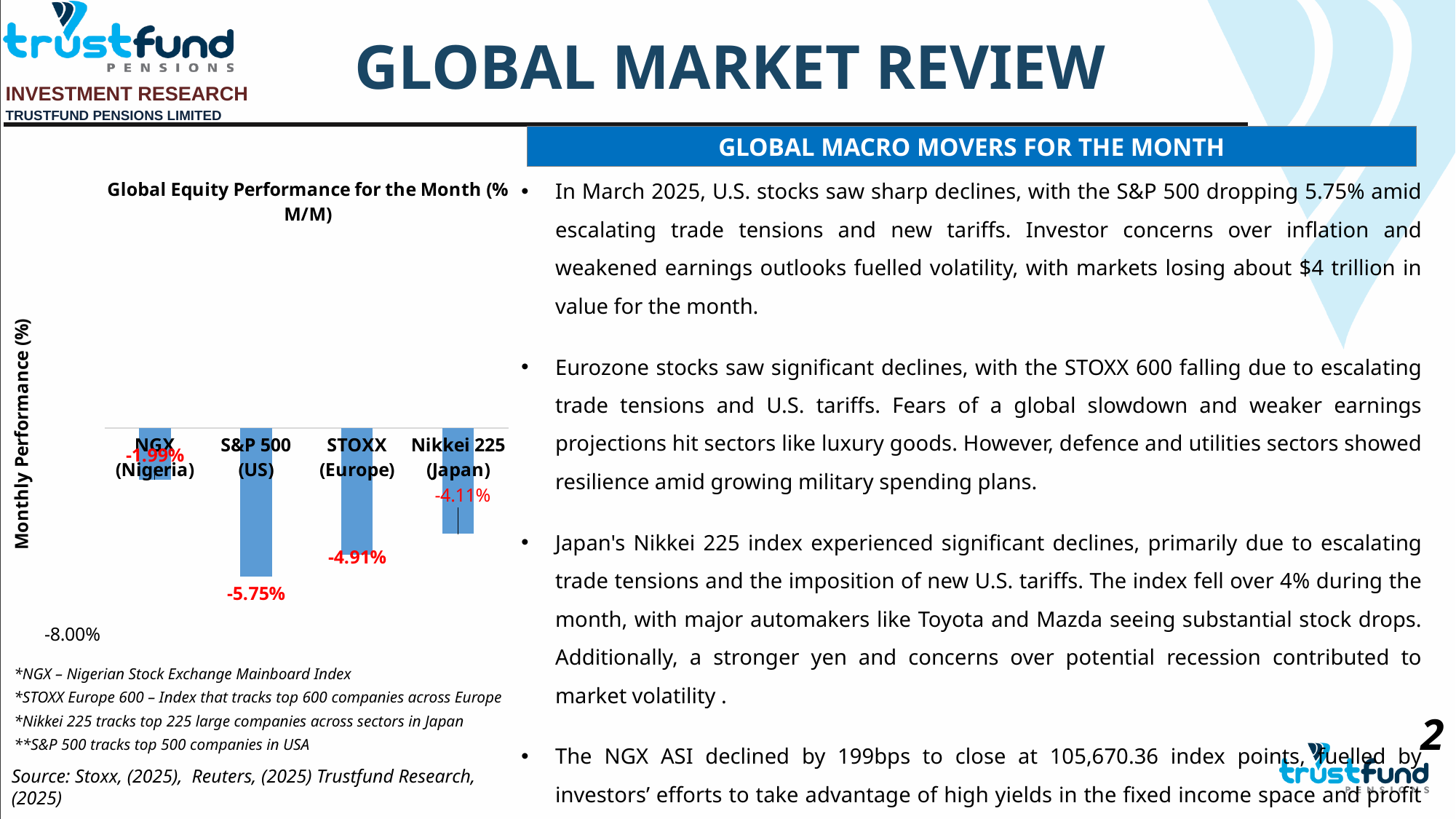
What is the monthly performance value shown for the S&P 500 (US)? -5.75% What is the title of the chart? Global Equity Performance for the Month (% M/M) How many indices are plotted in the chart? 4 What is the difference in percentage points between the S&P 500 (US) and NGX (Nigeria) values? 3.76 percentage points What is the monthly performance value shown for STOXX (Europe)? -4.91% What type of chart is used to show the global equity performance? Bar chart Which index has the smallest decline in the chart? NGX (Nigeria) What is the monthly performance value shown for Nikkei 225 (Japan)? -4.11% What is the label on the vertical axis of the chart? Monthly Performance (%) Which declined more, STOXX (Europe) or Nikkei 225 (Japan)? STOXX (Europe) Which index has the largest decline in the chart? S&P 500 (US) What is the monthly performance value shown for NGX (Nigeria)? -1.99%